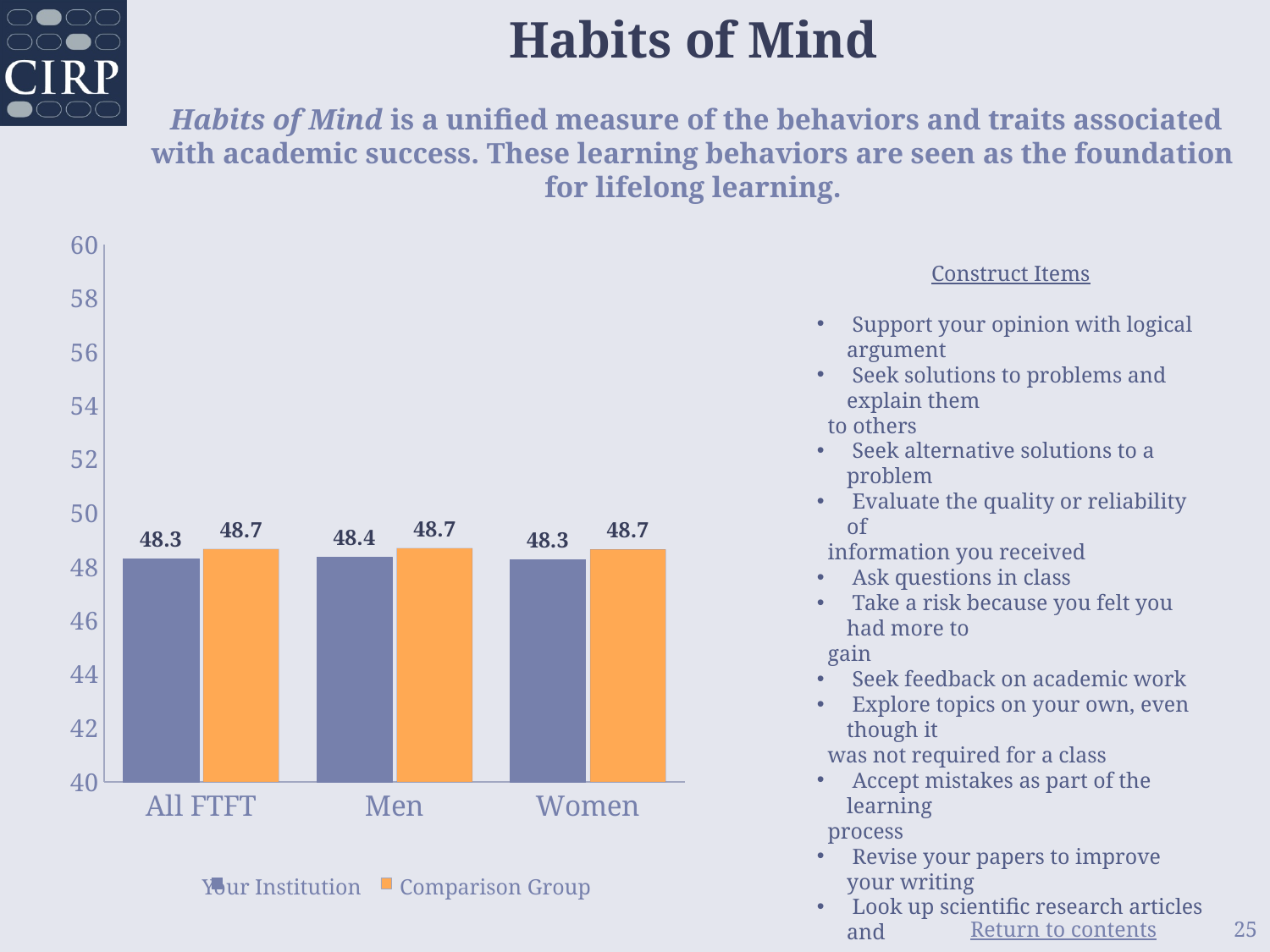
What is the difference between the Comparison Group and Your Institution values for All FTFT? 0.4 What is the difference between the Comparison Group and Your Institution values for Men? 0.3 What kind of chart is shown on the slide? bar chart Which category has the highest Your Institution value? Men How many series does the legend list? 2 What is the Your Institution value for All FTFT? 48.3 What is the Your Institution value for Men? 48.4 Is the Comparison Group value for Men greater or less than 50? less For Women, which is larger: Your Institution or Comparison Group? Comparison Group What is the title of the slide containing the chart? Habits of Mind How many categories are shown on the x axis? 3 What is the Comparison Group value for Women? 48.7